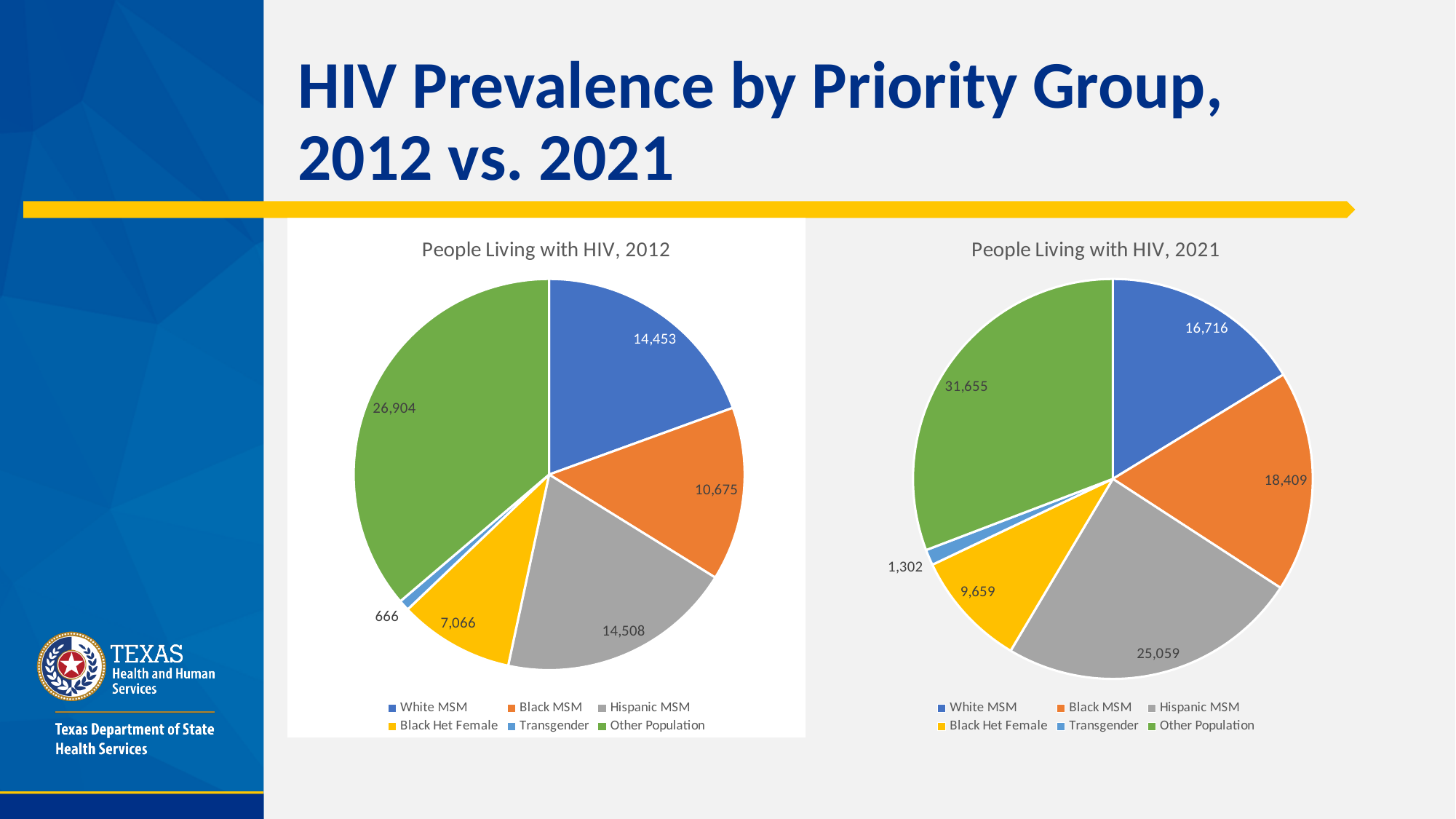
In the 'People Living with HIV, 2021' chart, what is the difference between Hispanic MSM and Black MSM? 6,650 In the 'People Living with HIV, 2012' chart, which group has the largest slice? Other Population In the 'People Living with HIV, 2021' chart, what is the value for Hispanic MSM? 25,059 In the 'People Living with HIV, 2012' chart, what is the value for Other Population? 26,904 In the 'People Living with HIV, 2021' chart, what is the value for Transgender? 1,302 What type of chart is 'People Living with HIV, 2021'? Pie chart How many slices does the 'People Living with HIV, 2012' chart have? 6 In the 'People Living with HIV, 2021' chart, which group has the smallest slice? Transgender In the 'People Living with HIV, 2021' chart, which colour represents Hispanic MSM? Gray In the 'People Living with HIV, 2021' chart, which is larger, Black MSM or Black Het Female? Black MSM In the 'People Living with HIV, 2012' chart, what is the difference between Other Population and White MSM? 12,451 In the 'People Living with HIV, 2012' chart, what is the value for Black Het Female? 7,066